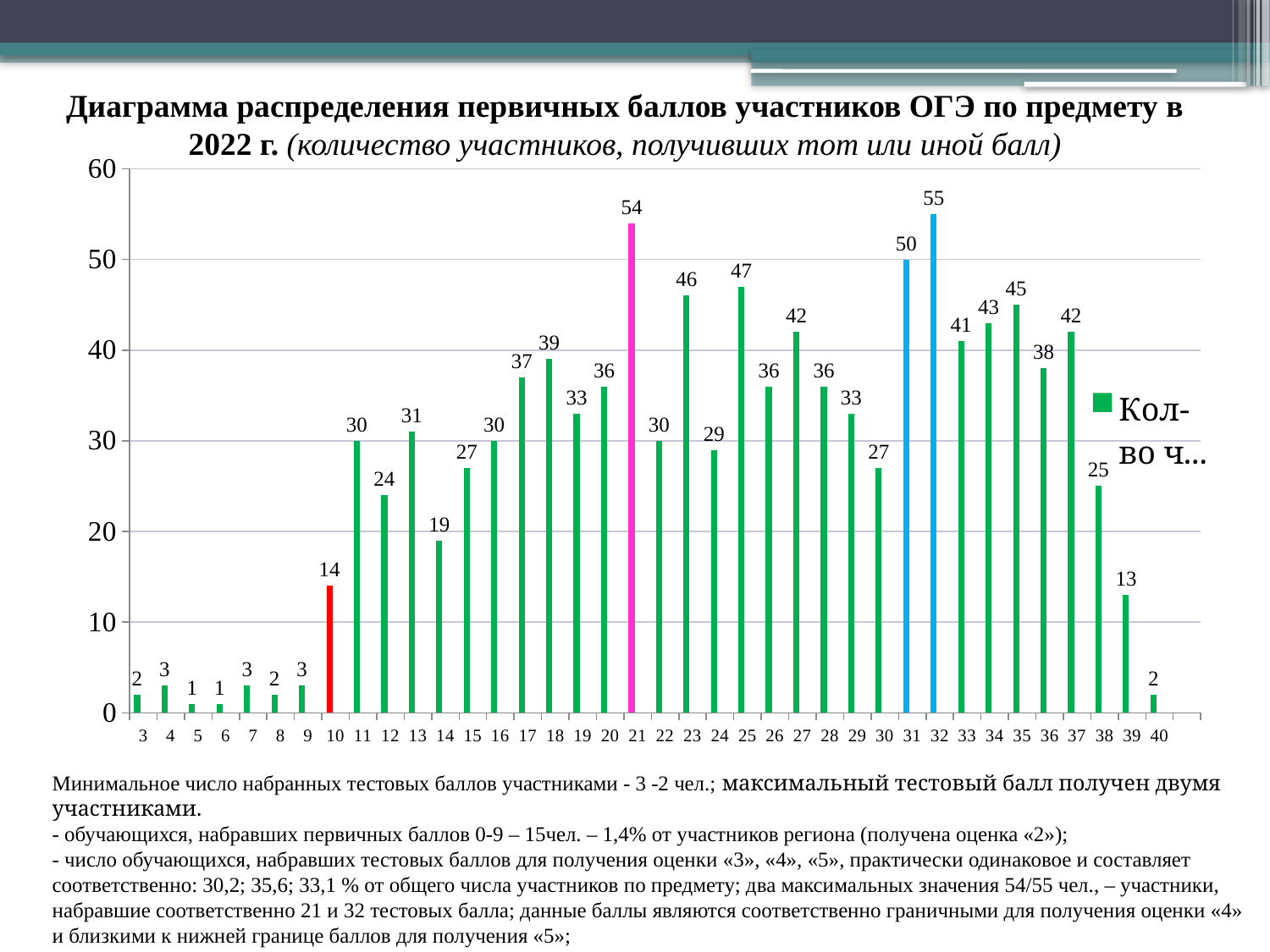
What is the difference between the values for score 31 and score 30? 23 What kind of chart is shown on the slide? bar chart How many score categories are shown on the x axis? 38 What is the value shown for score 39? 13 What is the value shown for score 32? 55 What is the difference between the values for score 32 and score 21? 1 How many participants received a primary score of 21? 54 How many series does the legend list? 1 What is the value shown for score 10? 14 Which has a larger value, score 24 or score 25? 25 Which primary score has the highest number of participants? 32 What colour is the bar for score 21? pink